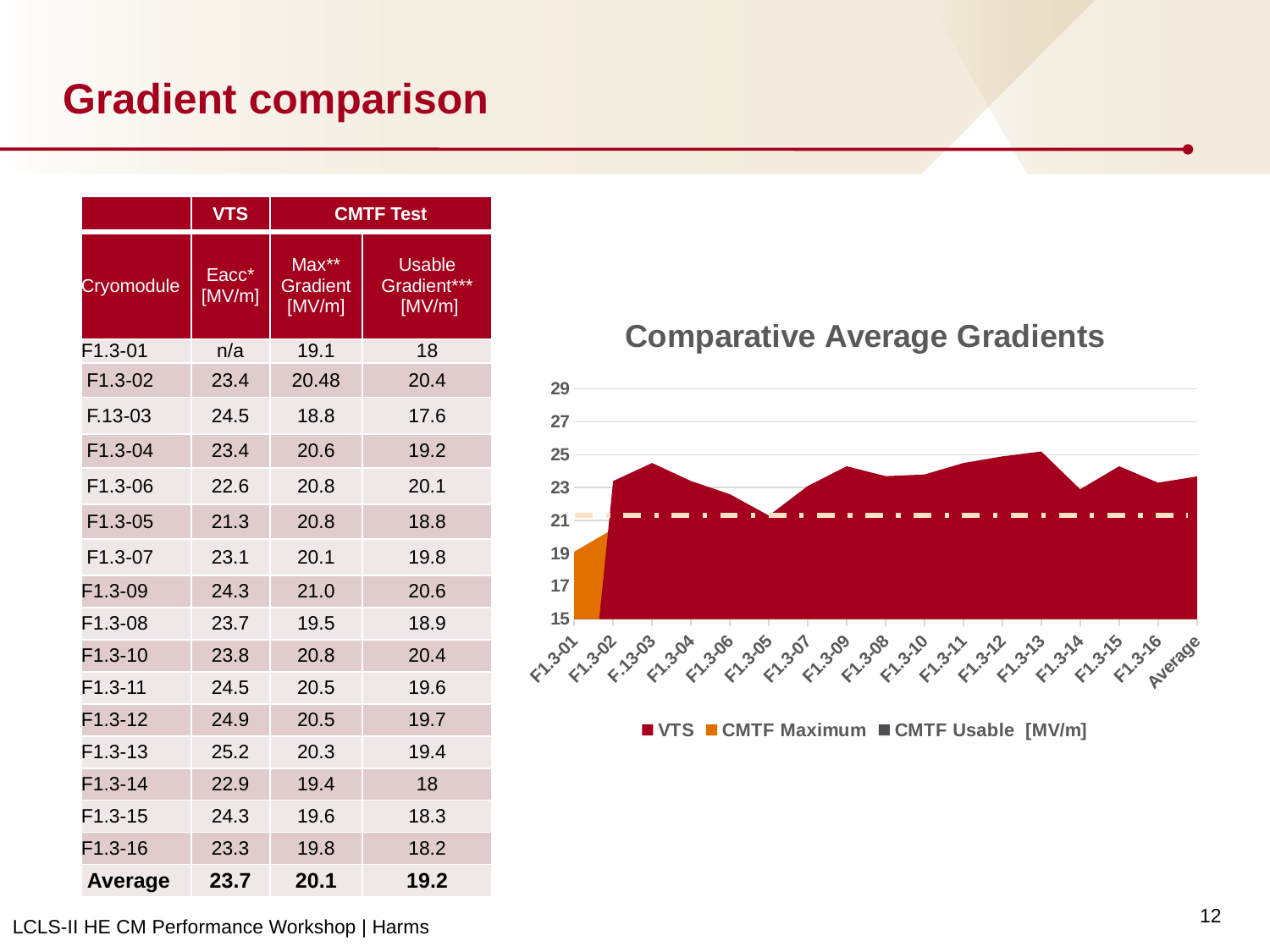
In the 'Comparative Average Gradients' chart, which cryomodule has the lowest VTS value among those with a plotted VTS value? F1.3-05 In the 'Comparative Average Gradients' chart, does the VTS value rise or fall from F1.3-13 to F1.3-14? fall In the 'Comparative Average Gradients' chart, is the VTS value for F1.3-12 larger or smaller than the VTS value for F1.3-05? larger In the 'Comparative Average Gradients' chart, is the VTS value for F.13-03 greater or less than 23? greater How many categories are shown along the x axis of the 'Comparative Average Gradients' chart? 17 In the 'Comparative Average Gradients' chart, is the VTS value for F1.3-14 greater or less than 25? less In the 'Comparative Average Gradients' chart, is the VTS value for Average greater or less than 21? greater What type of chart is shown under the title 'Comparative Average Gradients'? area chart What is the title of the chart on the slide? Comparative Average Gradients How many series does the legend of the 'Comparative Average Gradients' chart list? 3 What is the highest value shown on the y axis of the 'Comparative Average Gradients' chart? 29